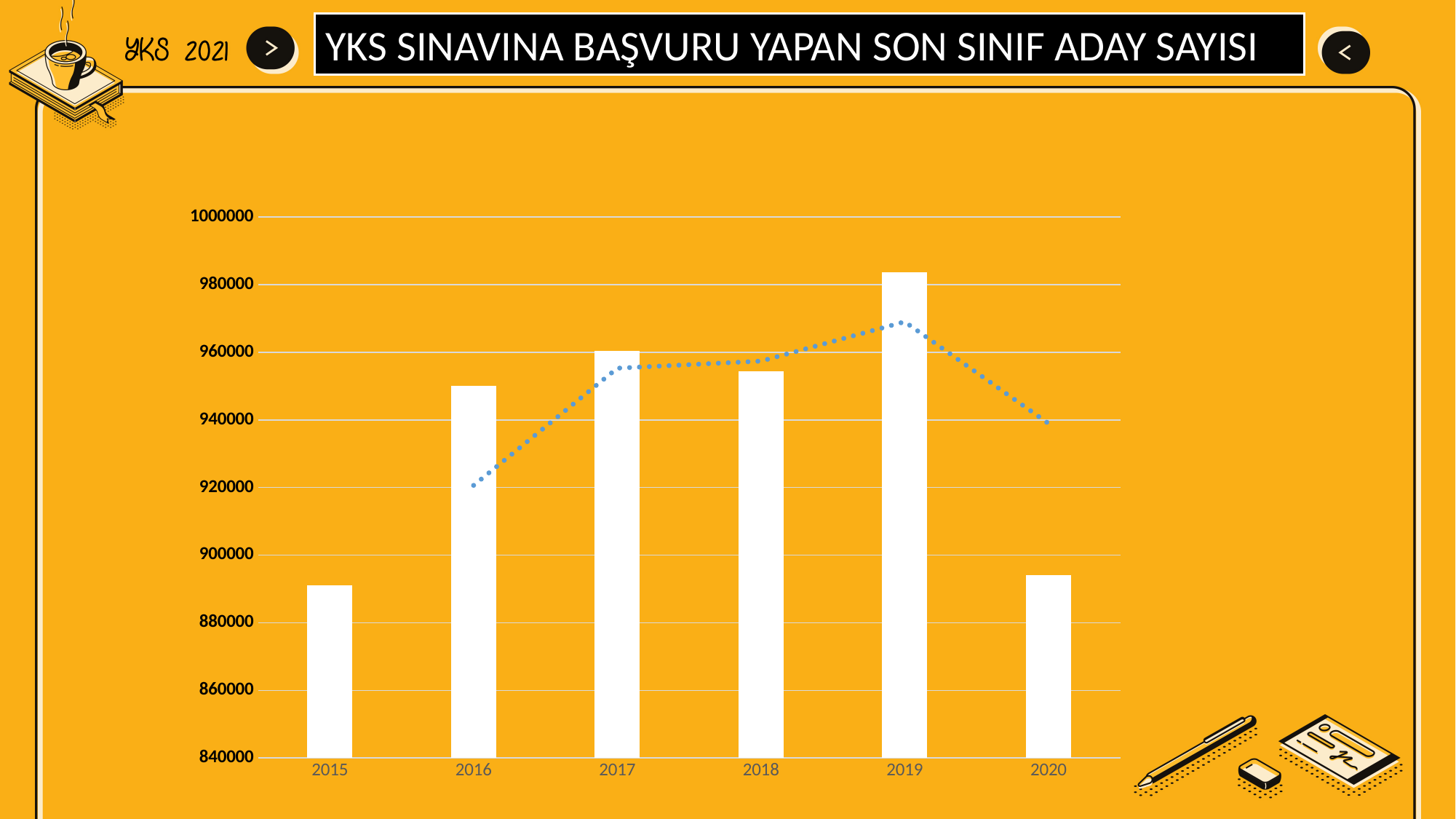
How many years are shown on the x axis of the chart? 6 What kind of chart is shown on the slide? bar chart Is the value for 2016 greater or less than 940000? greater Does the value rise or fall from 2019 to 2020? fall Which is larger, the value for 2015 or the value for 2017? 2017 Is the value for 2015 greater or less than 900000? less Which is larger, the value for 2016 or the value for 2019? 2019 Is the value for 2020 greater or less than 900000? less Which year has the highest bar in the chart? 2019 What is the title of the chart? YKS SINAVINA BAŞVURU YAPAN SON SINIF ADAY SAYISI